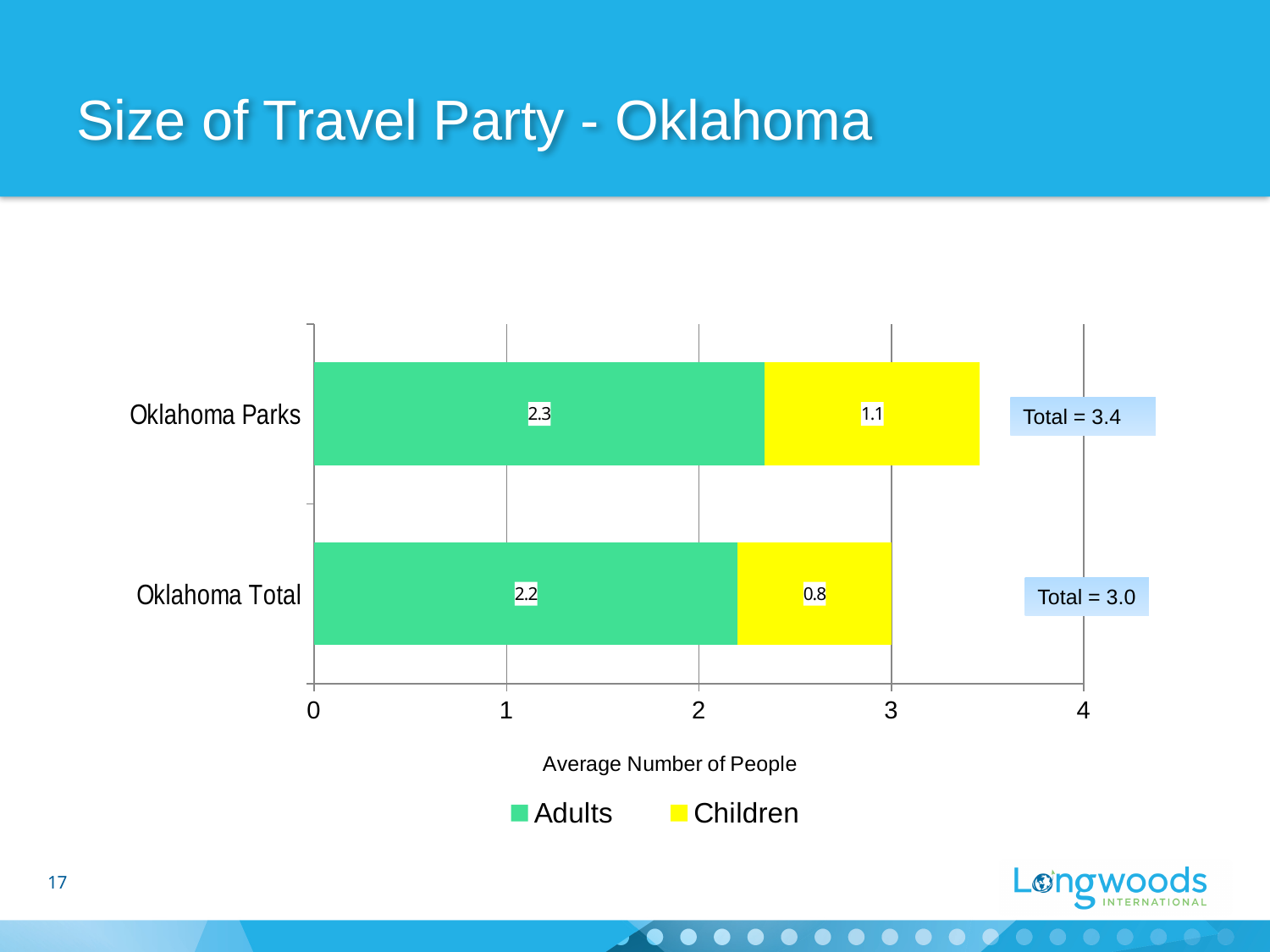
What is the difference in the average number of adults between Oklahoma Parks and Oklahoma Total? 0.1 What is the difference in the average number of children between Oklahoma Parks and Oklahoma Total? 0.3 What kind of chart is shown on the slide? Stacked bar chart What is the label of the x axis? Average Number of People What is the average number of children in the travel party for Oklahoma Total? 0.8 How many series does the legend list? 2 Which category has the larger average number of children, Oklahoma Parks or Oklahoma Total? Oklahoma Parks What is the average number of adults in the travel party for Oklahoma Parks? 2.3 What is the average number of children in the travel party for Oklahoma Parks? 1.1 How many categories are shown on the chart? 2 What is the total average travel party size for Oklahoma Total? 3.0 What is the total average travel party size for Oklahoma Parks? 3.4